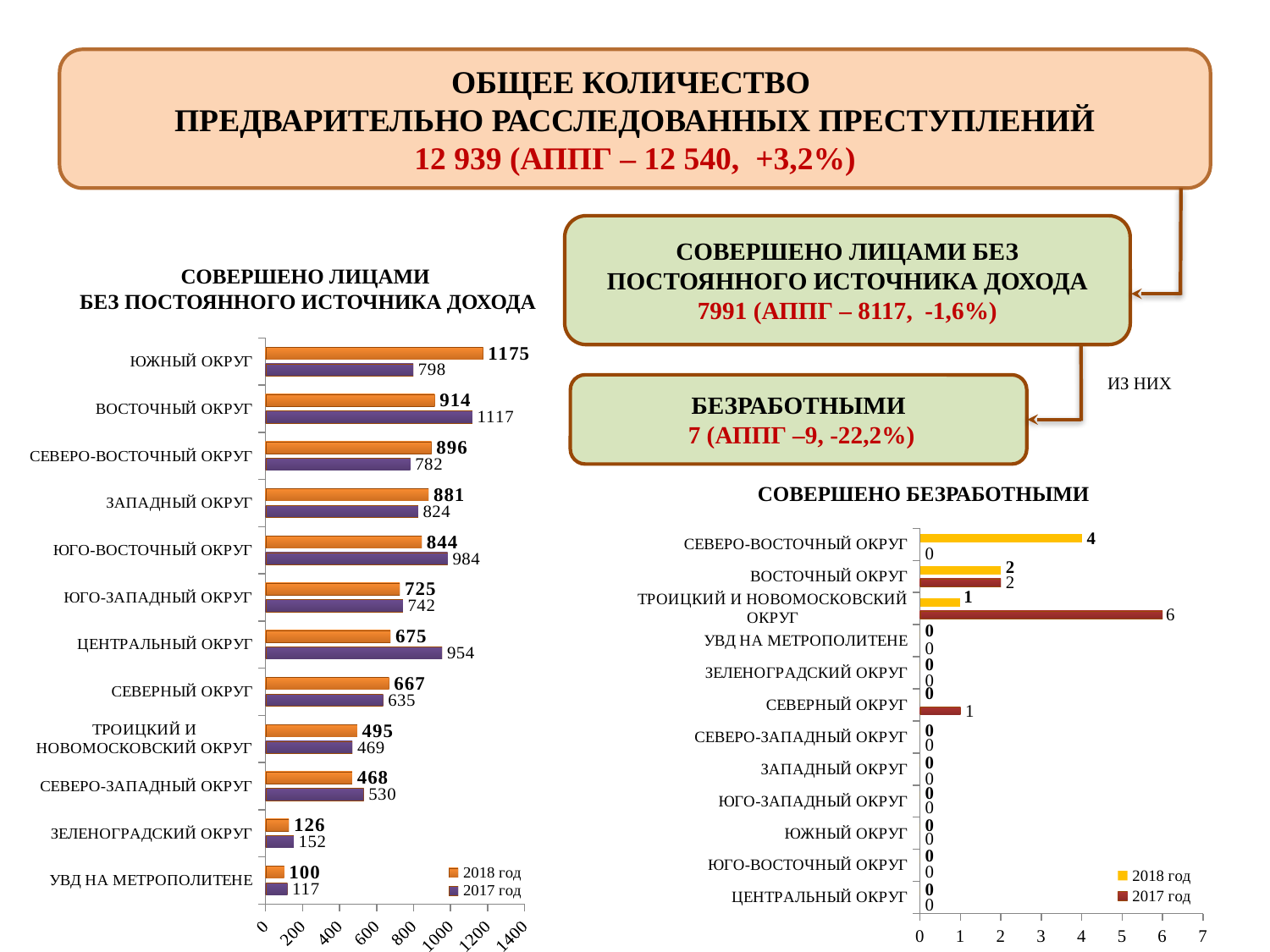
In the chart titled 'СОВЕРШЕНО БЕЗРАБОТНЫМИ', which category has the highest 2018 год value? СЕВЕРО-ВОСТОЧНЫЙ ОКРУГ In the chart titled 'СОВЕРШЕНО ЛИЦАМИ БЕЗ ПОСТОЯННОГО ИСТОЧНИКА ДОХОДА', which is larger for СЕВЕРНЫЙ ОКРУГ: the 2018 год value or the 2017 год value? 2018 год In the chart titled 'СОВЕРШЕНО БЕЗРАБОТНЫМИ', what is the 2017 год value for СЕВЕРНЫЙ ОКРУГ? 1 In the chart titled 'СОВЕРШЕНО ЛИЦАМИ БЕЗ ПОСТОЯННОГО ИСТОЧНИКА ДОХОДА', what is the 2017 год value for ЦЕНТРАЛЬНЫЙ ОКРУГ? 954 In the chart titled 'СОВЕРШЕНО БЕЗРАБОТНЫМИ', what is the 2017 год value for ТРОИЦКИЙ И НОВОМОСКОВСКИЙ ОКРУГ? 6 In the chart titled 'СОВЕРШЕНО ЛИЦАМИ БЕЗ ПОСТОЯННОГО ИСТОЧНИКА ДОХОДА', how many series does the legend list? 2 In the chart titled 'СОВЕРШЕНО ЛИЦАМИ БЕЗ ПОСТОЯННОГО ИСТОЧНИКА ДОХОДА', what is the difference between the 2018 год and 2017 год values for ВОСТОЧНЫЙ ОКРУГ? 203 In the chart titled 'СОВЕРШЕНО ЛИЦАМИ БЕЗ ПОСТОЯННОГО ИСТОЧНИКА ДОХОДА', which category has the highest 2018 год value? ЮЖНЫЙ ОКРУГ In the chart titled 'СОВЕРШЕНО ЛИЦАМИ БЕЗ ПОСТОЯННОГО ИСТОЧНИКА ДОХОДА', what is the 2018 год value for ЮЖНЫЙ ОКРУГ? 1175 In the chart titled 'СОВЕРШЕНО ЛИЦАМИ БЕЗ ПОСТОЯННОГО ИСТОЧНИКА ДОХОДА', how many categories are shown? 12 What kind of chart is the one titled 'СОВЕРШЕНО БЕЗРАБОТНЫМИ'? bar chart In the chart titled 'СОВЕРШЕНО ЛИЦАМИ БЕЗ ПОСТОЯННОГО ИСТОЧНИКА ДОХОДА', which category has the lowest 2017 год value? УВД НА МЕТРОПОЛИТЕНЕ